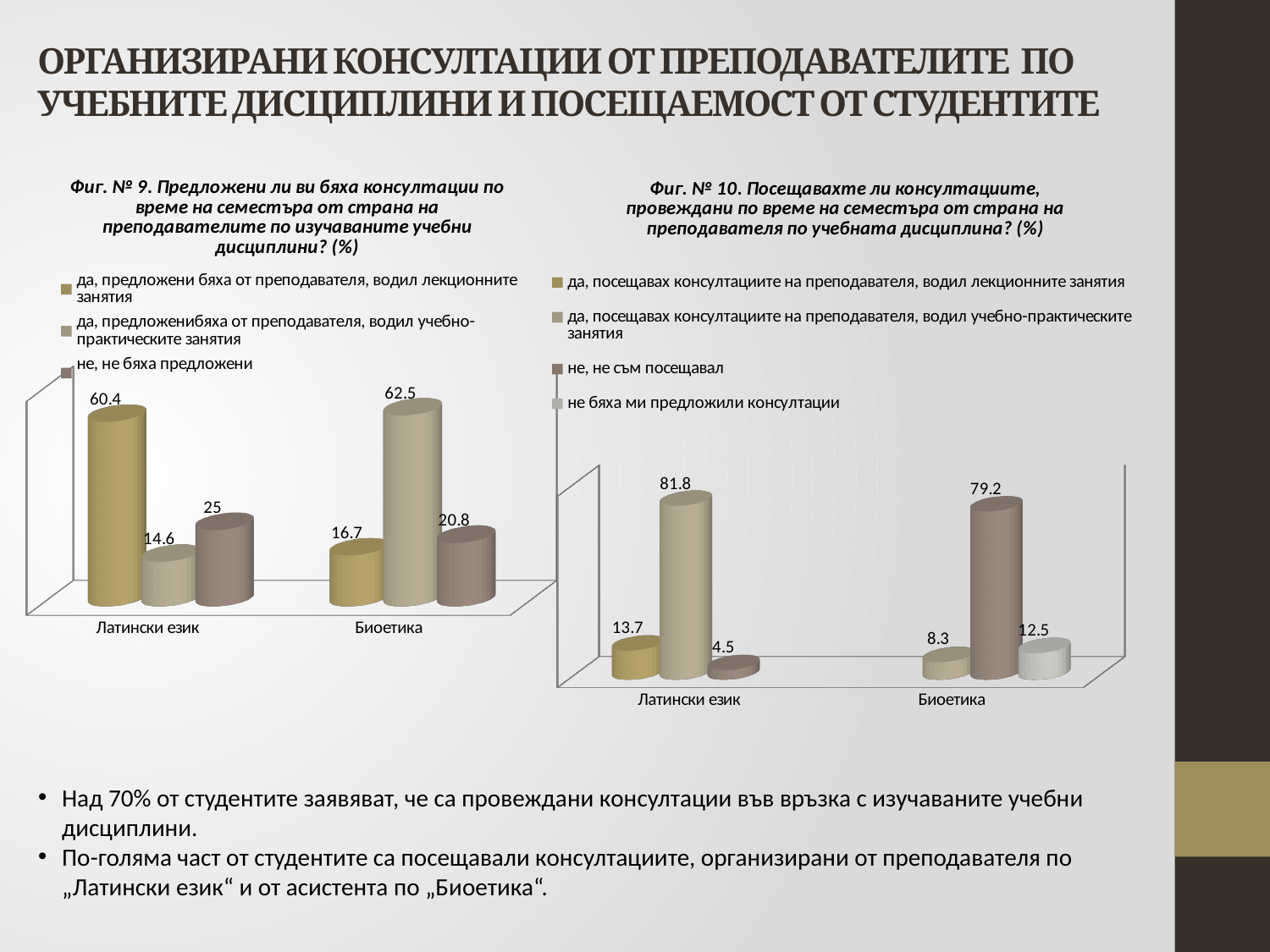
In Фиг. № 9, what is the value for 'да, предложени бяха от преподавателя, водил лекционните занятия' for Латински език? 60.4 In Фиг. № 10, what is the value for 'да, посещавах консултациите на преподавателя, водил учебно-практическите занятия' for Латински език? 81.8 In Фиг. № 10, what is the highest value shown for Биоетика? 79.2 How many series does the legend of Фиг. № 9 list? 3 How many series does the legend of Фиг. № 10 list? 4 In Фиг. № 9, what is the difference between the 'не, не бяха предложени' values for Латински език and Биоетика? 4.2 In Фиг. № 10, which is larger: the value 13.7 for Латински език or the value 8.3 for Биоетика? 13.7 for Латински език In Фиг. № 9, what is the value for 'да, предложени бяха от преподавателя, водил учебно-практическите занятия' for Биоетика? 62.5 In Фиг. № 10, what is the value for 'не, не съм посещавал' for Латински език? 4.5 What type of chart is Фиг. № 9? bar chart In Фиг. № 9, what is the value for 'не, не бяха предложени' for Биоетика? 20.8 In Фиг. № 9, which series has the highest value for Латински език? да, предложени бяха от преподавателя, водил лекционните занятия